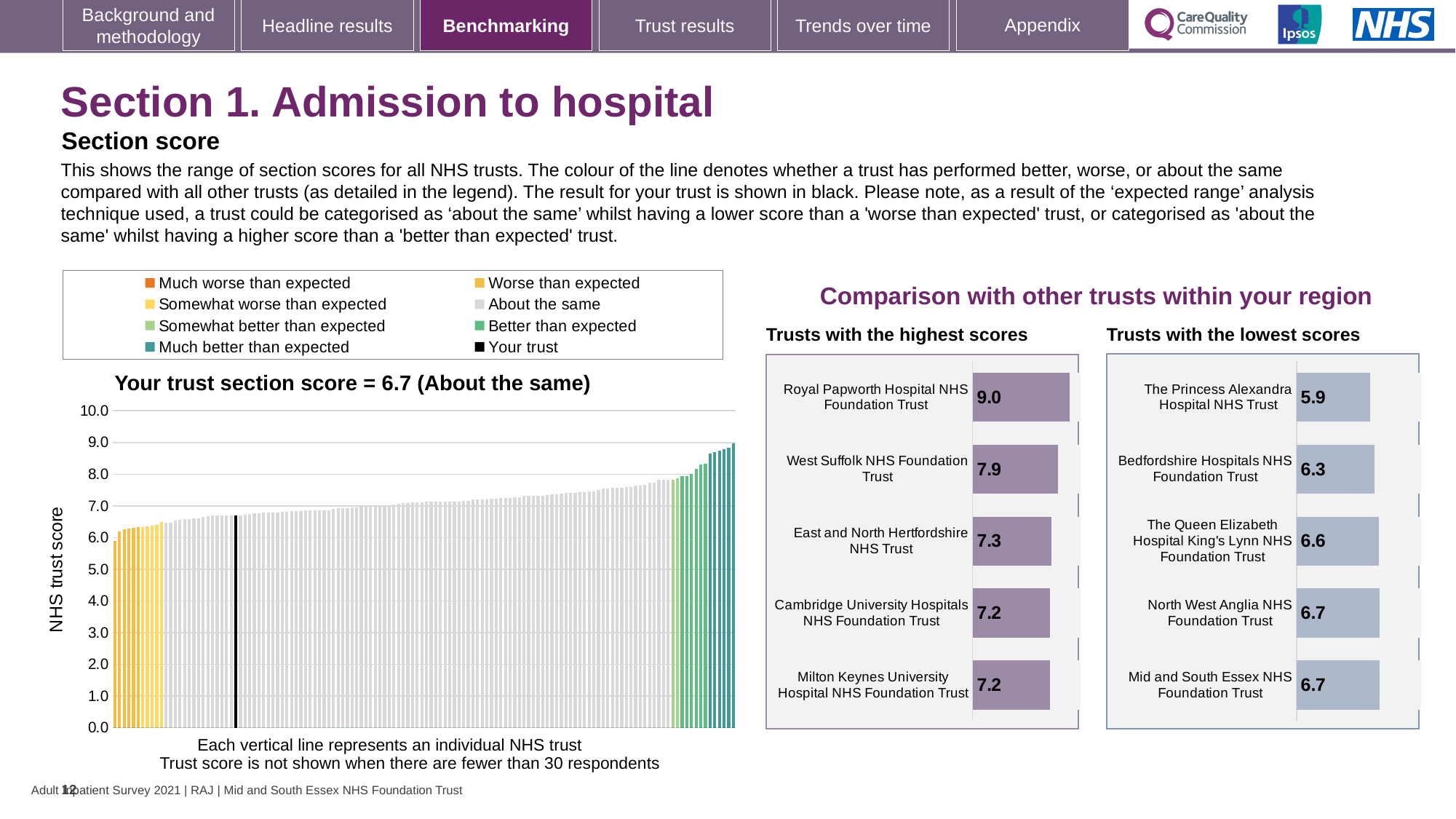
According to the title of the left-hand chart, what is your trust's section score? 6.7 In the 'Trusts with the highest scores' chart, what is the score for Royal Papworth Hospital NHS Foundation Trust? 9.0 In the 'Trusts with the highest scores' chart, what is the difference between the scores of Royal Papworth Hospital NHS Foundation Trust and West Suffolk NHS Foundation Trust? 1.1 How many entries does the legend above the left-hand chart list? 8 In the 'Trusts with the lowest scores' chart, which has the higher score: Bedfordshire Hospitals NHS Foundation Trust or The Queen Elizabeth Hospital King's Lynn NHS Foundation Trust? The Queen Elizabeth Hospital King's Lynn NHS Foundation Trust How many trusts are shown in the 'Trusts with the highest scores' chart? 5 In the 'Trusts with the highest scores' chart, which trust has the highest score? Royal Papworth Hospital NHS Foundation Trust What kind of chart is the left-hand chart showing all NHS trusts? Bar chart In the 'Trusts with the lowest scores' chart, which trust has the lowest score? The Princess Alexandra Hospital NHS Trust In the 'Trusts with the lowest scores' chart, what is the score for Mid and South Essex NHS Foundation Trust? 6.7 In the left-hand chart of all NHS trusts, do the scores rise or fall from left to right? Rise In the 'Trusts with the lowest scores' chart, what is the score for The Princess Alexandra Hospital NHS Trust? 5.9